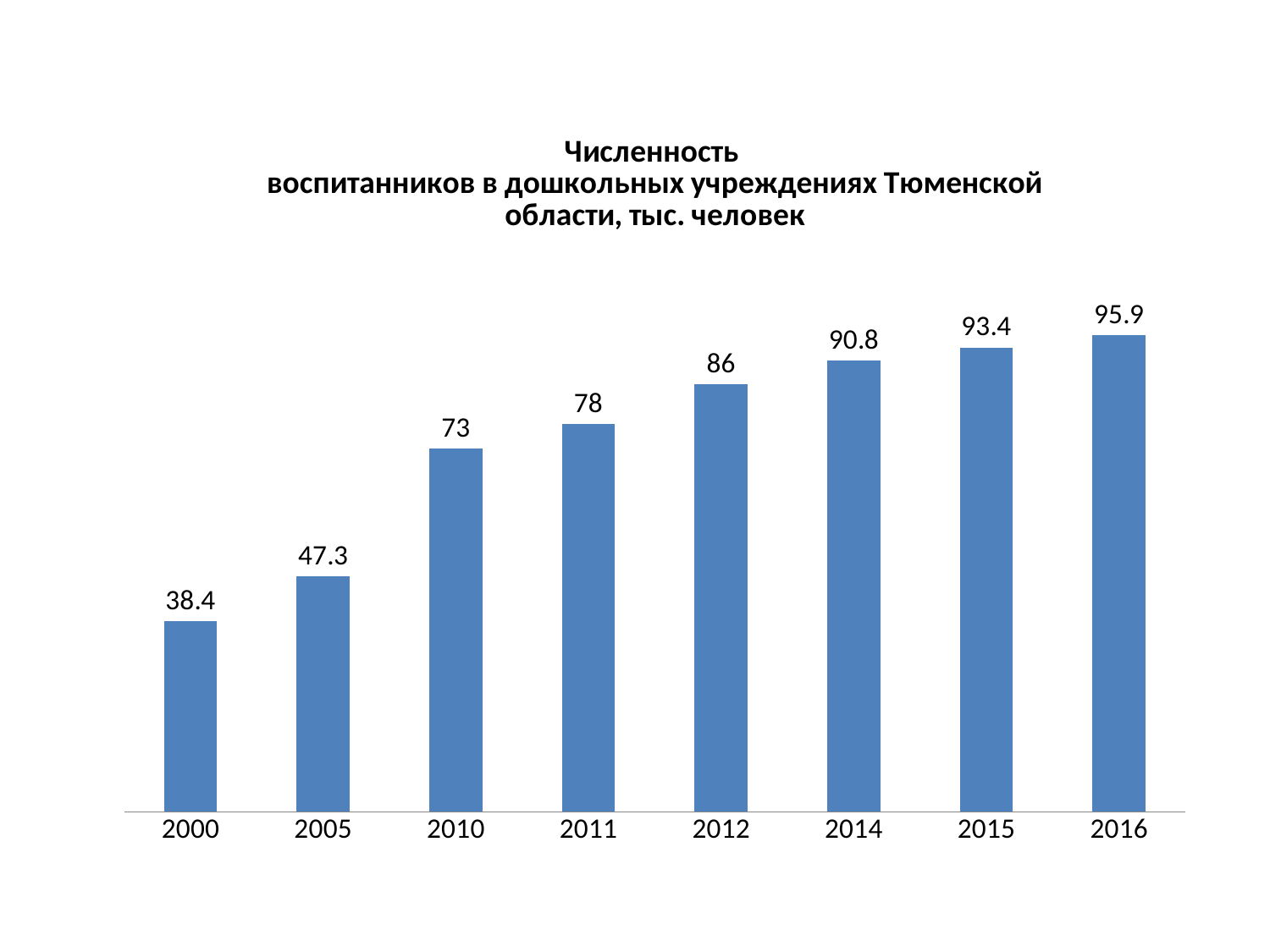
What is the value for 2015? 93.4 What is the value for 2000? 38.4 Which year has the highest value? 2016 What is the difference between the values for 2011 and 2010? 5 Which year has the lowest value? 2000 Do the values rise or fall from 2000 to 2016? rise What kind of chart is this? bar chart How many years are shown on the x axis? 8 What unit is given in the chart title? тыс. человек Which is larger, the value for 2005 or the value for 2010? 2010 What is the value for 2012? 86 What is the difference between the values for 2016 and 2000? 57.5